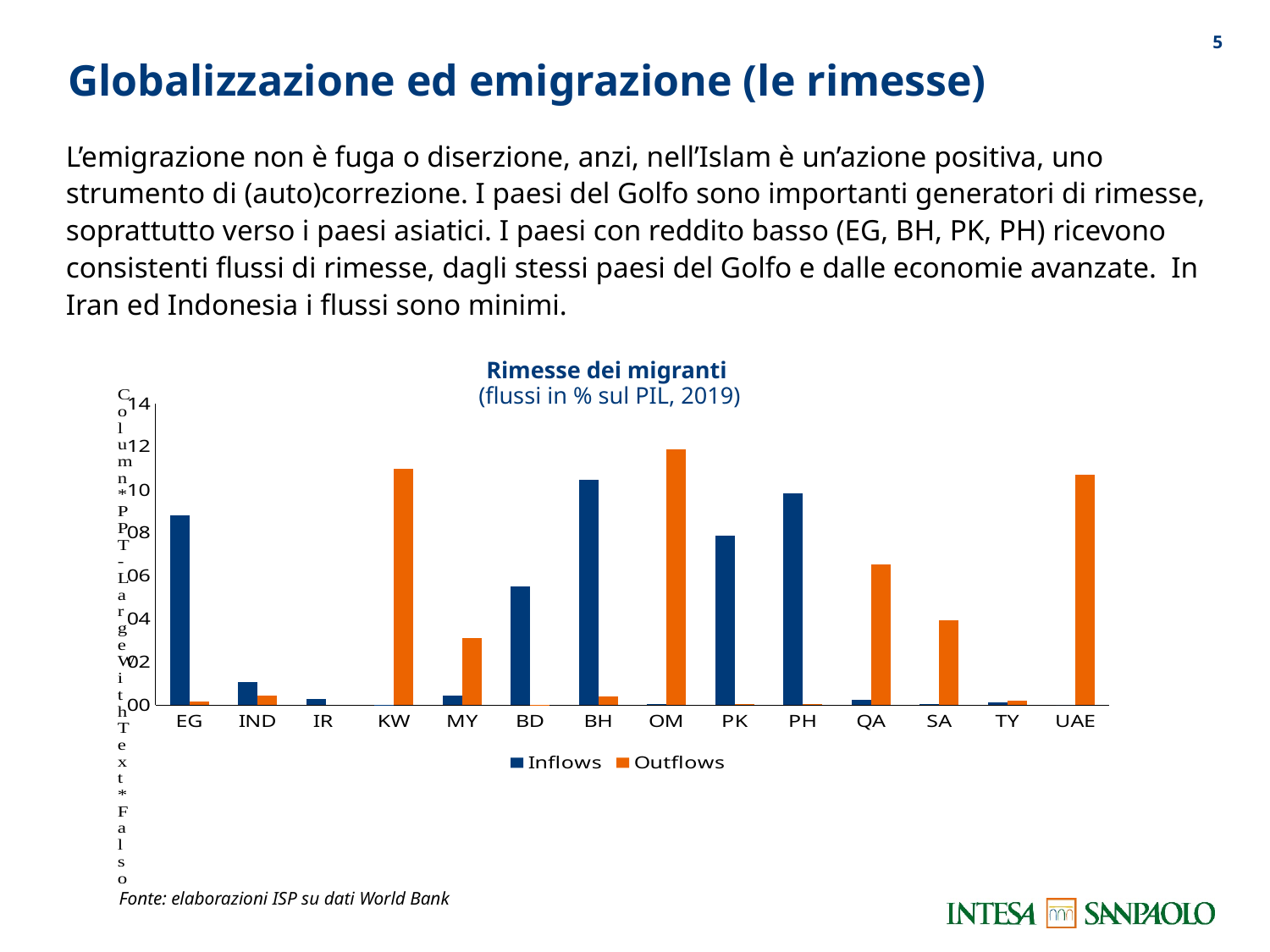
Which is larger, the Inflows value for EG or the Inflows value for PK? EG What colour are the Outflows bars in the 'Rimesse dei migranti' chart? orange How many countries are shown on the x axis of the 'Rimesse dei migranti' chart? 14 Is the Outflows value for KW greater or less than 10? greater Is the Inflows value for BD greater or less than 4? greater Is the Inflows value for EG greater or less than 8? greater How many series does the legend list in the 'Rimesse dei migranti' chart? 2 Which is larger, the Outflows value for UAE or the Outflows value for SA? UAE What kind of chart is shown on the slide? bar chart Which country has the highest Outflows value in the 'Rimesse dei migranti' chart? OM